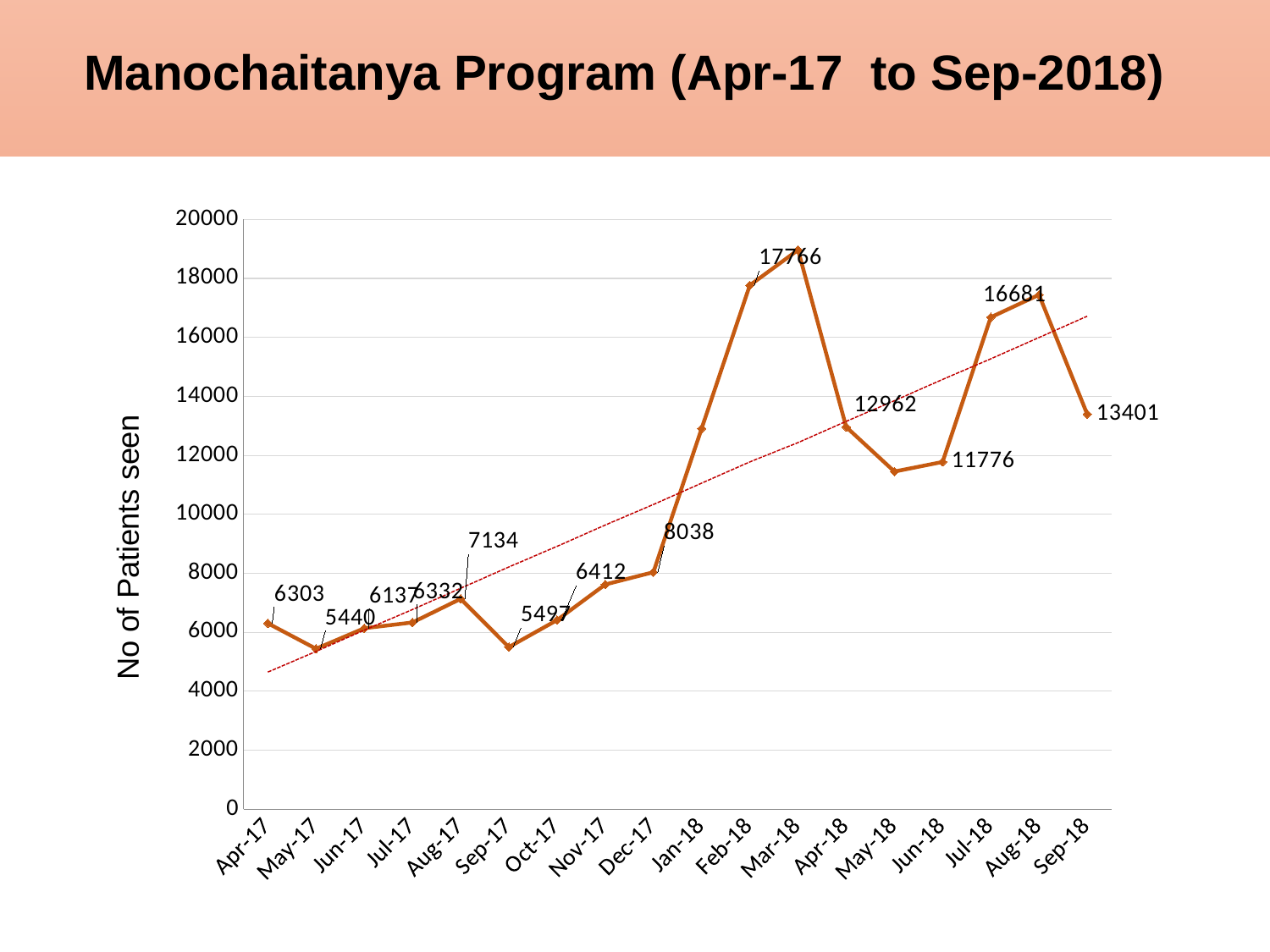
What is the title of the y axis? No of Patients seen What is the number of patients seen in Sep-18? 13401 What is the number of patients seen in Dec-17? 8038 What type of chart is shown on the slide? Line chart Which month has the highest number of patients seen? Mar-18 What is the number of patients seen in Apr-18? 12962 Which month has the lowest number of patients seen? May-17 Is the value for Mar-18 greater or less than 18000? greater Is the value for Nov-17 greater or less than 8000? less What is the number of patients seen in Apr-17? 6303 How many months are plotted on the x axis? 18 What is the difference between the values for Sep-18 and Apr-18? 439